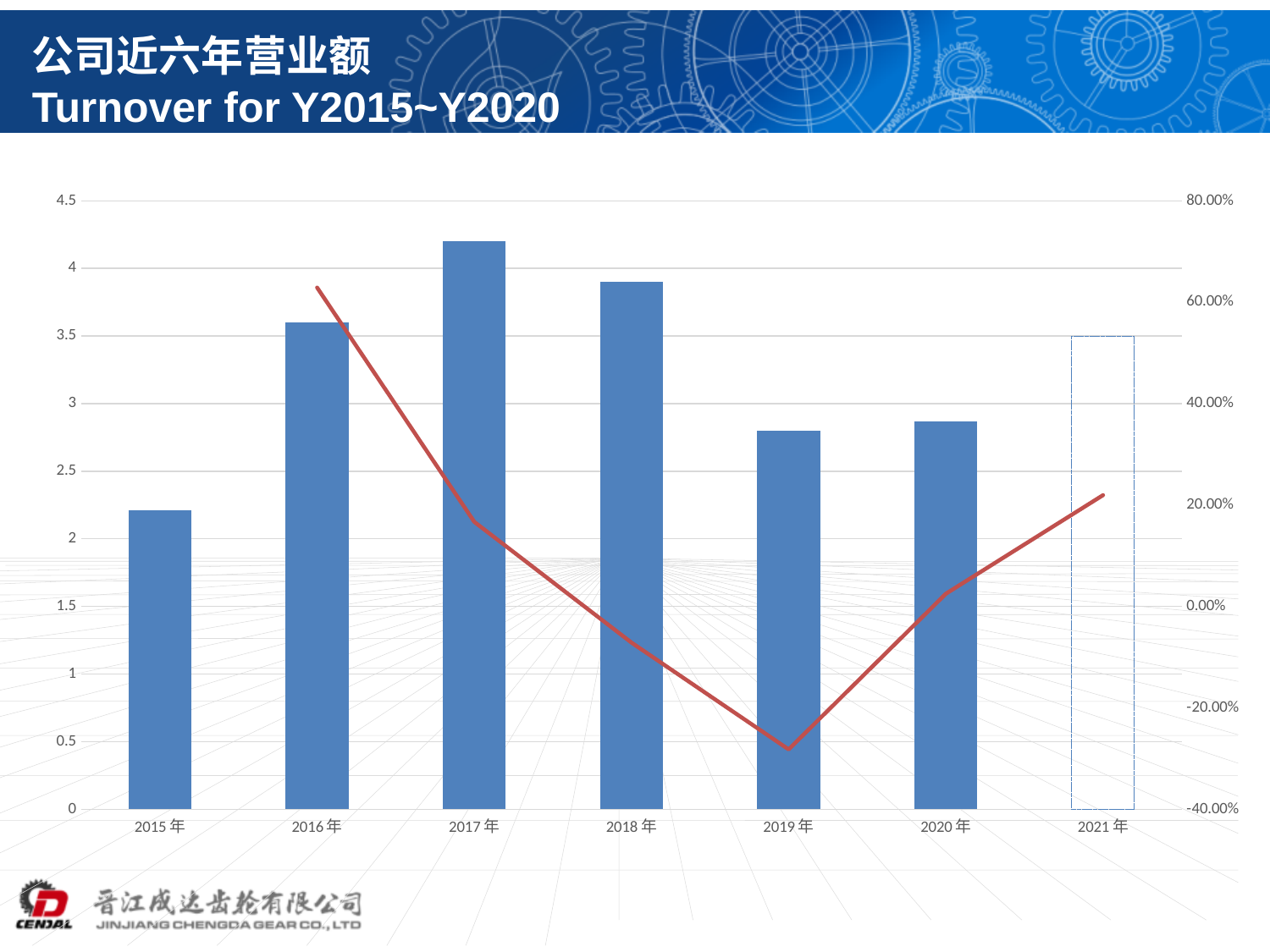
Which bar is taller, 2016年 or 2018年? 2018年 How many year categories are labeled on the x axis? 7 What kind of chart is shown on the slide? bar chart with a line Among the filled bars, which year has the lowest value? 2015年 In which year does the red line reach its lowest point? 2019年 Which year has the tallest bar? 2017年 Do the bar values rise or fall from 2017年 to 2019年? fall Is the bar value for 2015年 greater or less than 2? greater Is the bar value for 2018年 greater or less than 4? less Is the bar value for 2019年 greater or less than 3? less What is the English title of the chart? Turnover for Y2015~Y2020